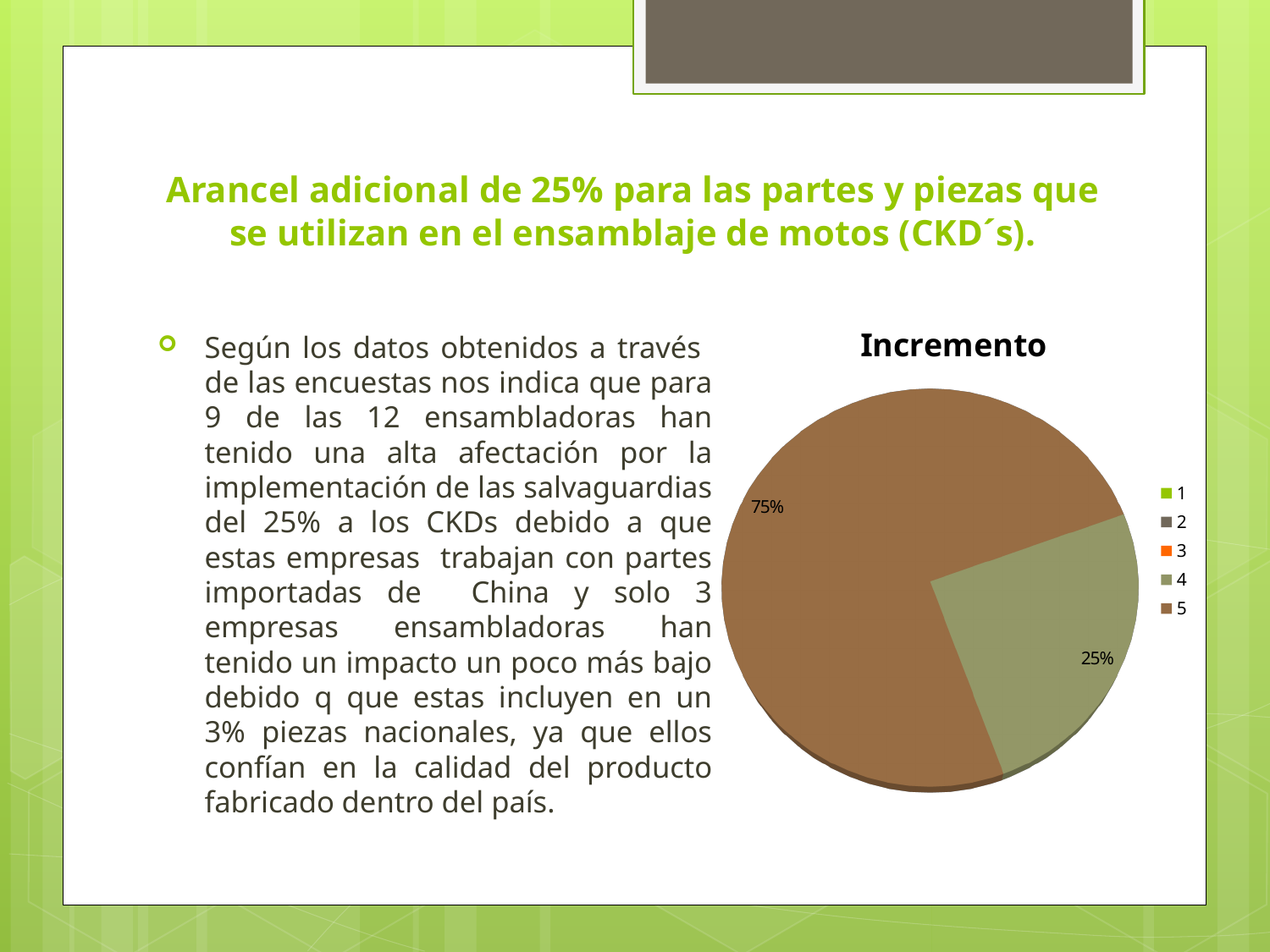
What is the share of the smallest visible slice in the pie chart? 25% Is the share of the largest slice in the pie chart greater or less than 50%? greater What share of the pie chart does the olive green slice (legend entry 4) represent? 25% What kind of chart is shown on the slide? pie chart What do the two visible slices of the pie chart add up to? 100% How many entries does the legend of the pie chart list? 5 What is the difference in percentage points between the two visible slices of the pie chart? 50 What share of the pie chart does the brown slice (legend entry 5) represent? 75% How many slices are visible in the pie chart? 2 What is the share of the largest slice in the pie chart? 75% Which is larger in the pie chart, the brown slice or the olive green slice? the brown slice What is the title of the pie chart? Incremento